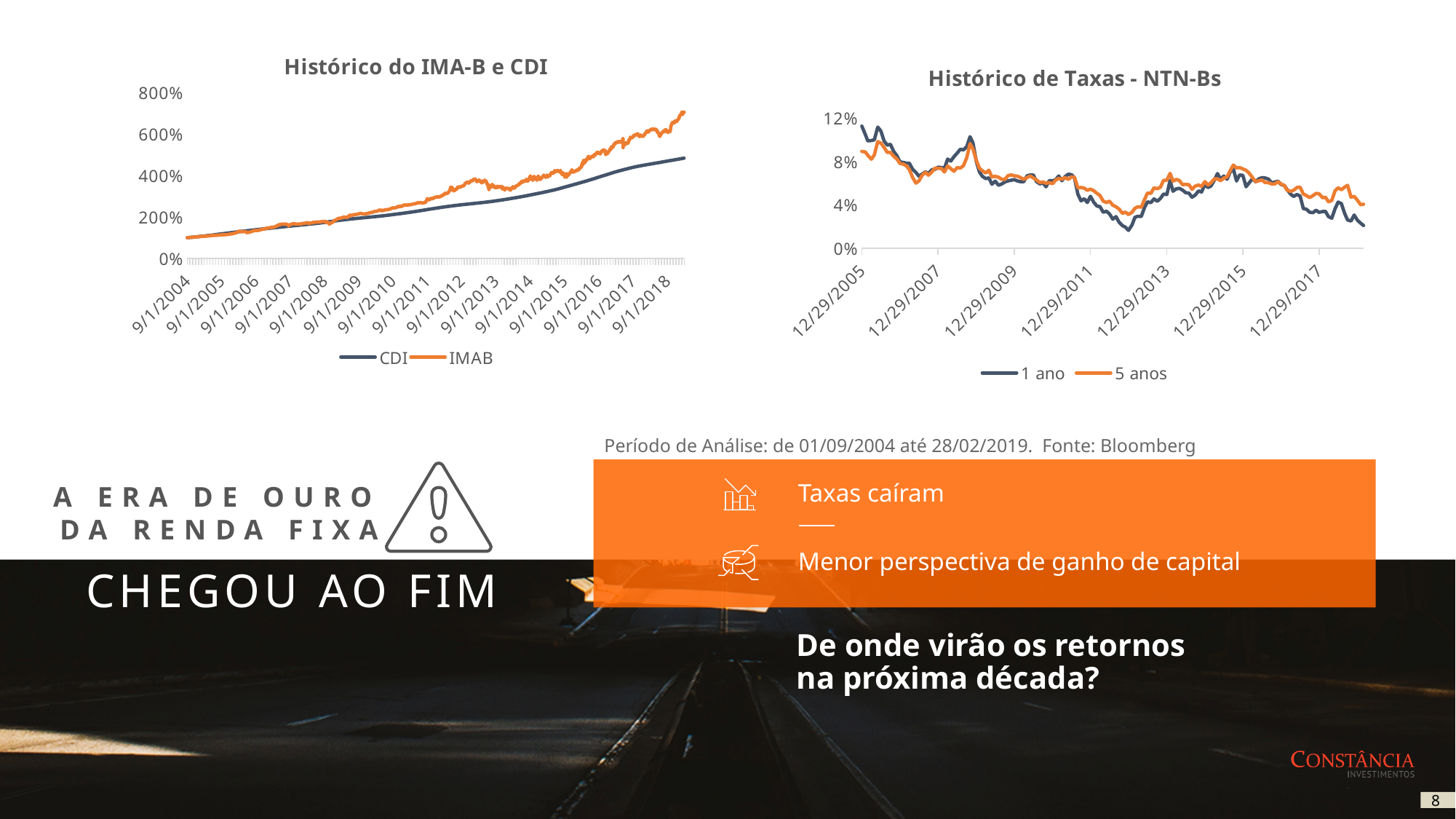
In the 'Histórico do IMA-B e CDI' chart, is the final value of IMAB greater or less than 600%? greater How many series does the legend of the 'Histórico de Taxas - NTN-Bs' chart list? 2 What are the two series named in the legend of the 'Histórico de Taxas - NTN-Bs' chart? 1 ano and 5 anos How many series does the legend of the 'Histórico do IMA-B e CDI' chart list? 2 What kind of chart is the 'Histórico do IMA-B e CDI' chart? line chart In the 'Histórico de Taxas - NTN-Bs' chart, do the values generally rise or fall from 12/29/2005 to the end of the period? fall In the 'Histórico do IMA-B e CDI' chart, which series is higher at the end of the period, CDI or IMAB? IMAB In the 'Histórico de Taxas - NTN-Bs' chart, is the value of '1 ano' at the start of the period greater or less than 8%? greater In the 'Histórico do IMA-B e CDI' chart, do the values generally rise or fall along the x axis? rise In the 'Histórico de Taxas - NTN-Bs' chart, is the value of '1 ano' at the end of the period greater or less than 4%? less What kind of chart is the 'Histórico de Taxas - NTN-Bs' chart? line chart